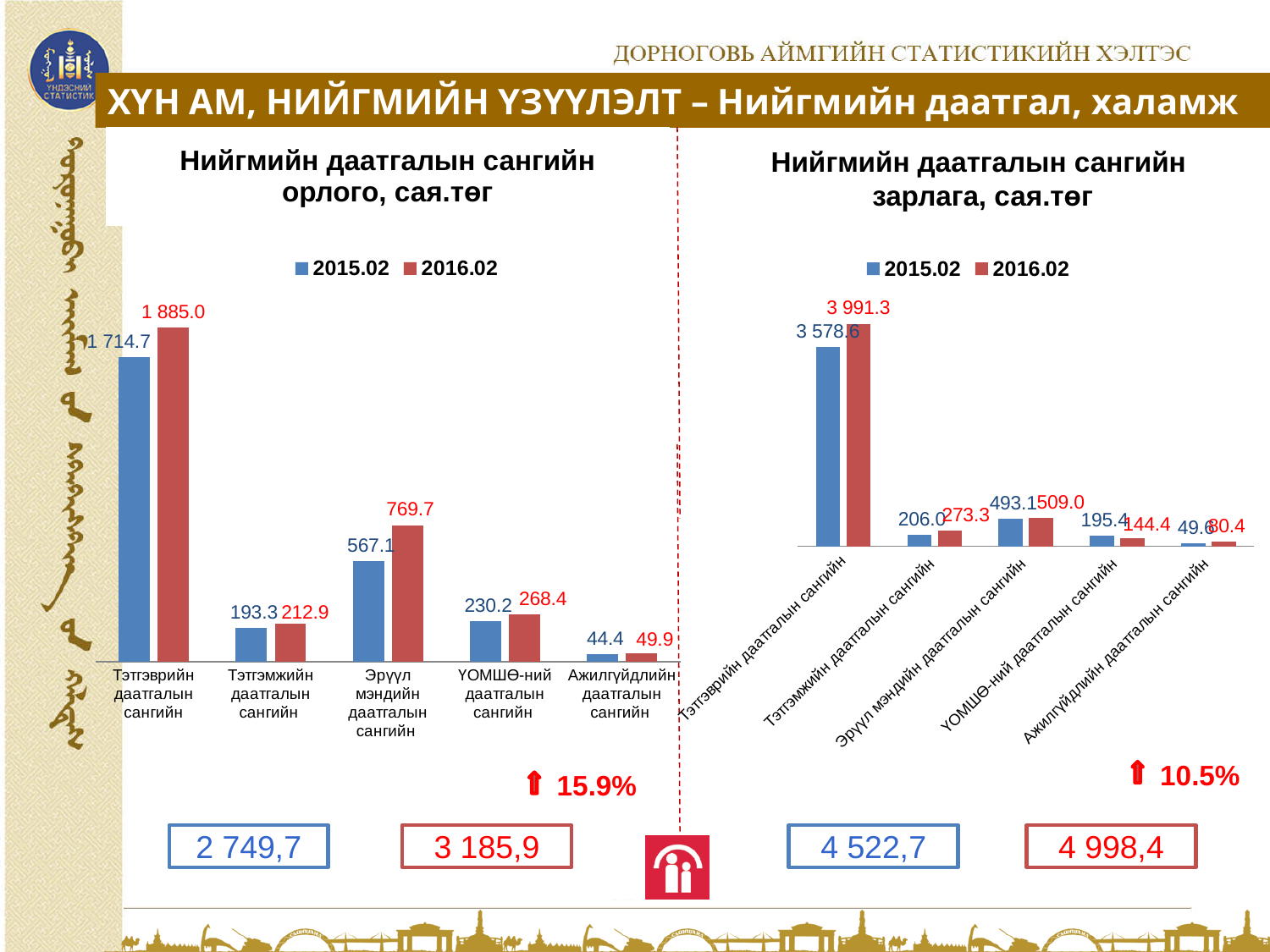
How many series does the legend of the right chart (Нийгмийн даатгалын сангийн зарлага) list? 2 In the right chart (Нийгмийн даатгалын сангийн зарлага), which category has the highest 2015.02 value? Тэтгэврийн даатгалын сангийн In the right chart (Нийгмийн даатгалын сангийн зарлага), which is larger for ҮОМШӨ-ний даатгалын сангийн: the 2015.02 value or the 2016.02 value? 2015.02 In the left chart (Нийгмийн даатгалын сангийн орлого), what is the 2016.02 value for Тэтгэврийн даатгалын сангийн? 1 885.0 What type of chart is the left chart (Нийгмийн даатгалын сангийн орлого)? Bar chart How many categories are shown on the x axis of the left chart (Нийгмийн даатгалын сангийн орлого)? 5 In the right chart (Нийгмийн даатгалын сангийн зарлага), what is the 2016.02 value for Тэтгэврийн даатгалын сангийн? 3 991.3 In the left chart (Нийгмийн даатгалын сангийн орлого), which category has the lowest 2016.02 value? Ажилгүйдлийн даатгалын сангийн In the right chart (Нийгмийн даатгалын сангийн зарлага), what is the difference between the 2016.02 and 2015.02 values for Тэтгэмжийн даатгалын сангийн? 67.3 In the right chart (Нийгмийн даатгалын сангийн зарлага), what is the 2015.02 value for ҮОМШӨ-ний даатгалын сангийн? 195.4 In the left chart (Нийгмийн даатгалын сангийн орлого), what is the difference between the 2016.02 and 2015.02 values for Эрүүл мэндийн даатгалын сангийн? 202.6 In the left chart (Нийгмийн даатгалын сангийн орлого), what is the 2015.02 value for Эрүүл мэндийн даатгалын сангийн? 567.1